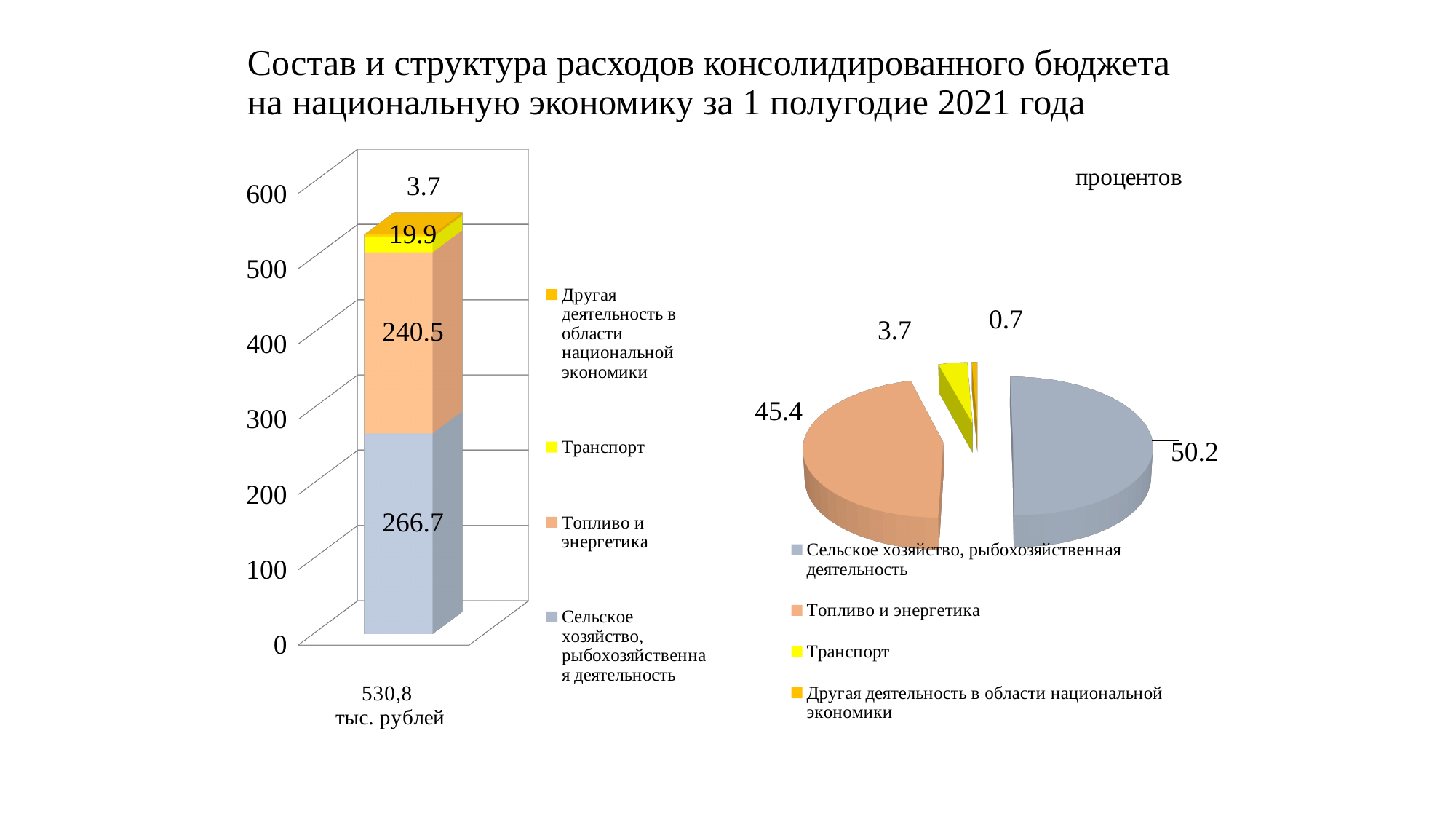
What kind of chart is on the left side of the slide? stacked bar chart In the right pie chart, what share does Сельское хозяйство, рыбохозяйственная деятельность have? 50.2 In the right pie chart, which slice is the largest? Сельское хозяйство, рыбохозяйственная деятельность In the left bar chart, what is the value for Транспорт? 19.9 In the left bar chart, which series has the smallest value? Другая деятельность в области национальной экономики In the left bar chart, how many series does the legend list? 4 In the right pie chart, what is the value for Транспорт? 3.7 What kind of chart is on the right side of the slide? pie chart In the left bar chart, what is the value for Топливо и энергетика? 240.5 In the left bar chart, what is the total of the stacked bar as printed on the slide? 530,8 тыс. рублей In the left bar chart, what is the difference between the values for Сельское хозяйство, рыбохозяйственная деятельность and Топливо и энергетика? 26.2 In the left bar chart, what is the value for Сельское хозяйство, рыбохозяйственная деятельность? 266.7